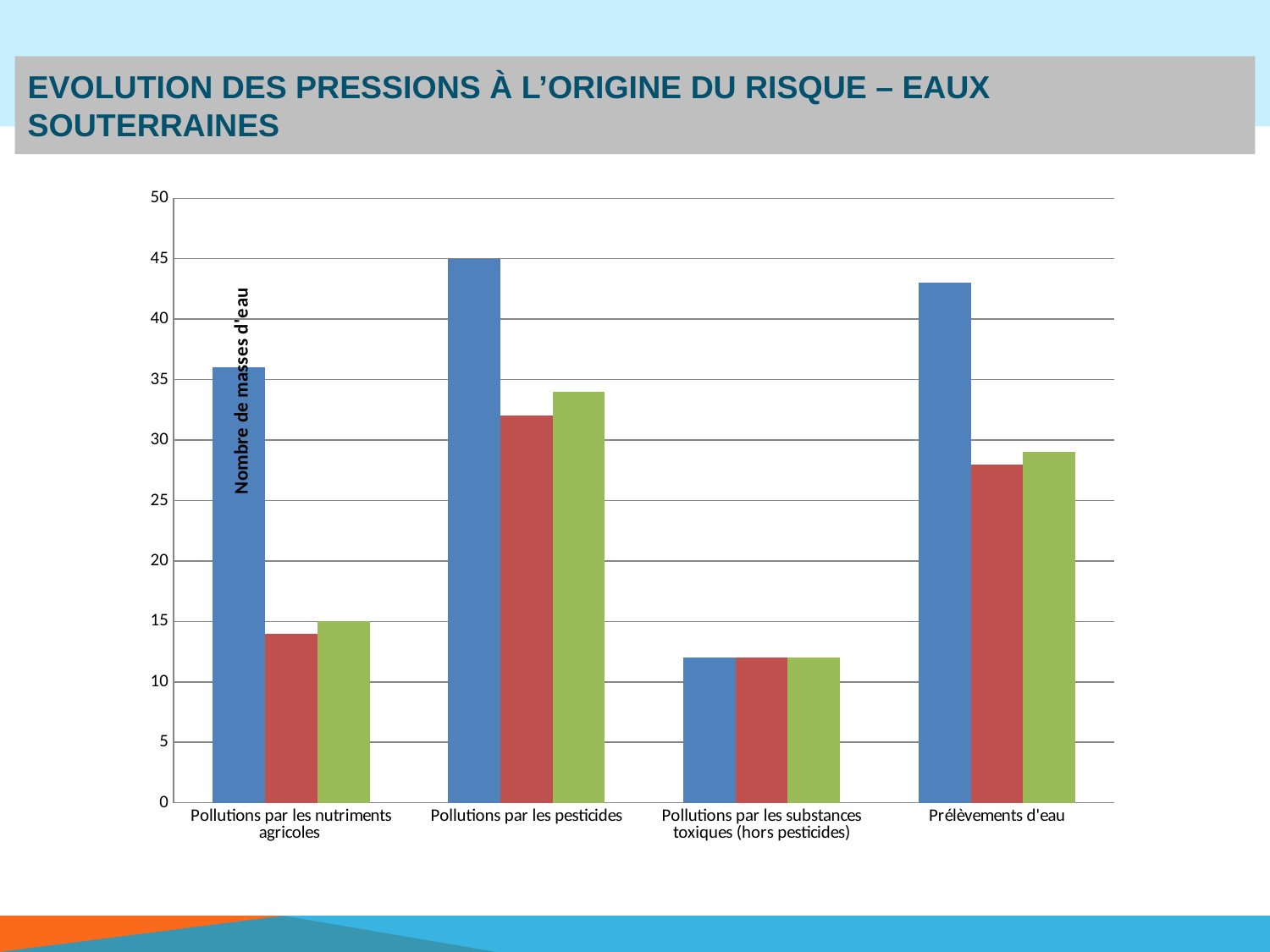
Is the value of the blue bar for 'Prélèvements d'eau' greater or less than 40? greater How many categories are shown on the x axis of the chart? 4 Is the value of the red bar for 'Pollutions par les pesticides' greater or less than 30? greater What kind of chart is shown on the slide? bar chart Which category has the shortest blue bar? Pollutions par les substances toxiques (hors pesticides) Is the value of the red bar for 'Pollutions par les nutriments agricoles' greater or less than 15? less Which category has the tallest blue bar? Pollutions par les pesticides What is the value of the blue bar for 'Pollutions par les pesticides'? 45 What is the value of the green bar for 'Pollutions par les nutriments agricoles'? 15 What is the title of the vertical axis of the chart? Nombre de masses d'eau How many bars are plotted for each category in the chart? 3 Which is larger: the blue bar for 'Pollutions par les pesticides' or the blue bar for 'Pollutions par les nutriments agricoles'? Pollutions par les pesticides